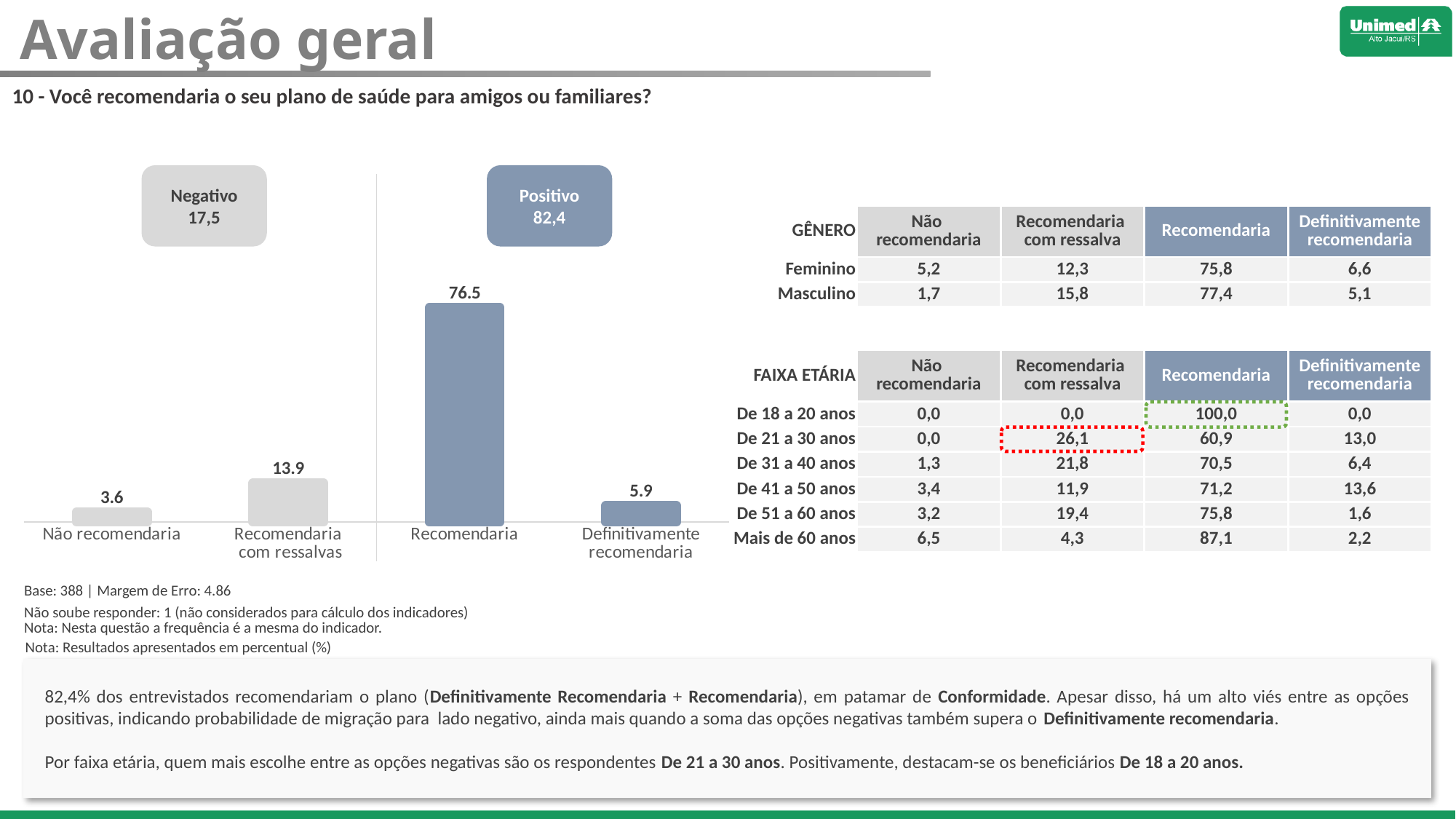
What is the value for "Recomendaria" in the bar chart? 76.5 Which is larger in the bar chart: "Recomendaria com ressalvas" or "Definitivamente recomendaria"? Recomendaria com ressalvas What is the difference between the values for "Recomendaria" and "Recomendaria com ressalvas" in the bar chart? 62.6 Which category has the lowest value in the bar chart? Não recomendaria What is the total of the two negative categories ("Não recomendaria" and "Recomendaria com ressalvas") in the bar chart? 17.5 What value is shown in the "Positivo" box above the bar chart? 82,4 How many categories are shown in the bar chart? 4 What is the value for "Não recomendaria" in the bar chart? 3.6 Which category has the highest value in the bar chart? Recomendaria What kind of chart is shown on the slide? Bar chart What is the value for "Recomendaria com ressalvas" in the bar chart? 13.9 What is the value for "Definitivamente recomendaria" in the bar chart? 5.9